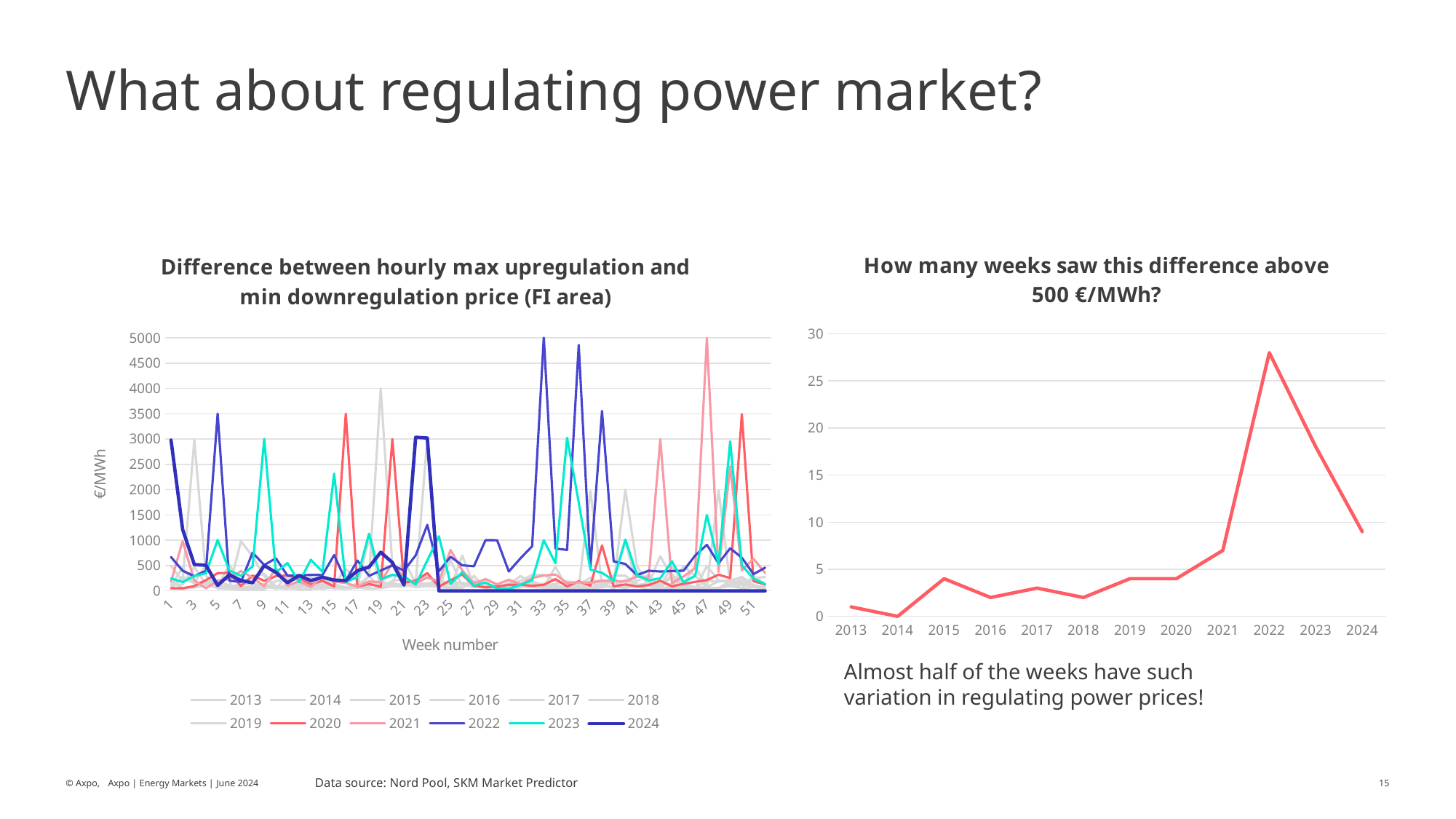
On the right chart, what is the value for 2014? 0 On the right chart, how many years are plotted along the x axis? 12 On the right chart, which is larger, the value for 2022 or the value for 2023? 2022 On the right chart titled "How many weeks saw this difference above 500 €/MWh?", which year has the lowest value? 2014 On the right chart titled "How many weeks saw this difference above 500 €/MWh?", which year has the highest value? 2022 On the right chart, do the values rise or fall from 2022 to 2024? fall On the right chart, is the value for 2022 greater or less than 25? greater On the left chart, how many series does the legend list? 12 On the right chart, is the value for 2021 greater or less than 10? less What kind of chart is the left chart titled "Difference between hourly max upregulation and min downregulation price (FI area)"? line chart On the left chart, what is the label of the x axis? Week number On the right chart, is the value for 2023 greater or less than 15? greater